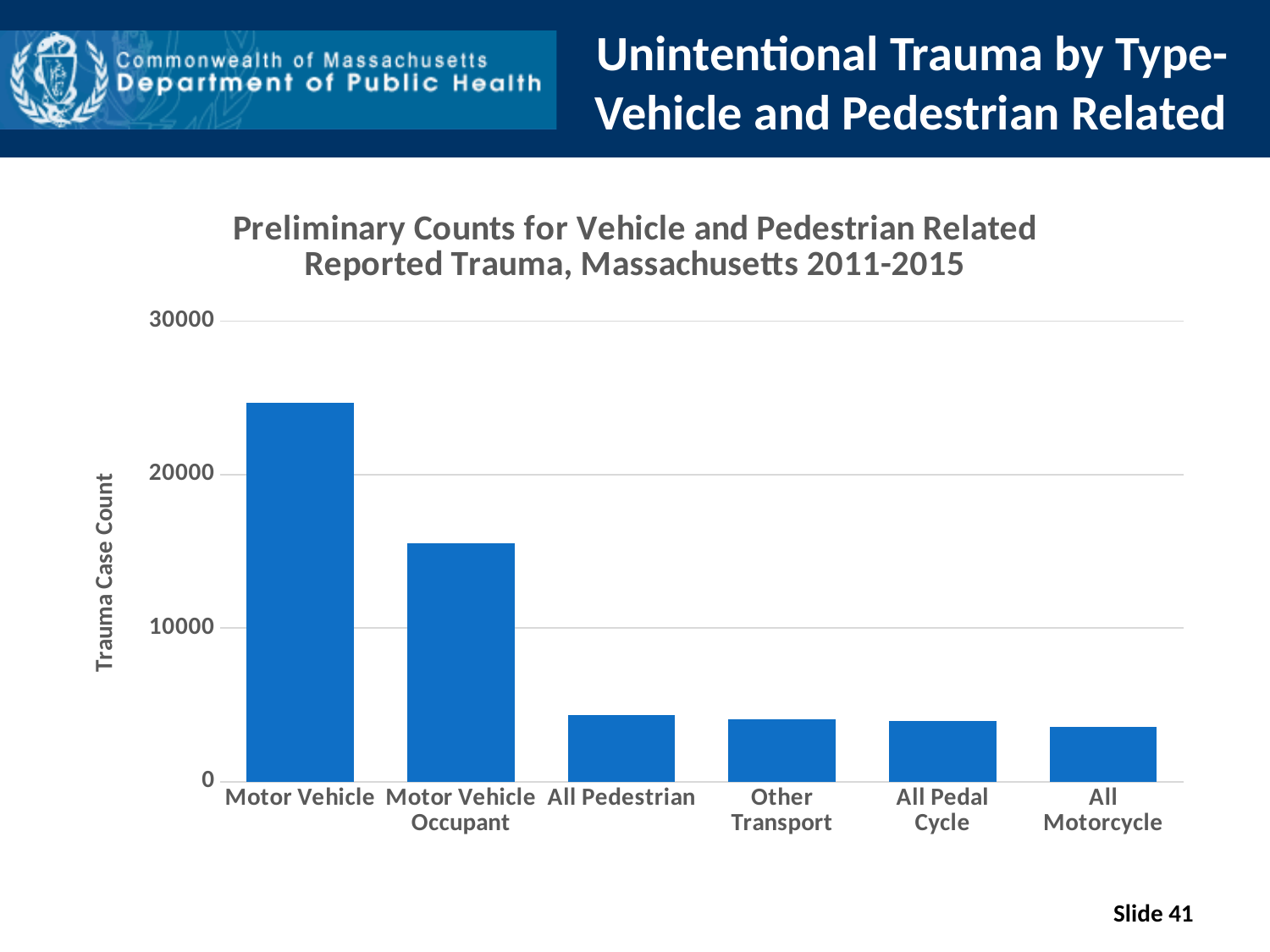
What is the label on the y axis of the chart? Trauma Case Count How many categories are shown on the x axis of the chart? 6 What kind of chart is shown on the slide? bar chart Is the value for Motor Vehicle Occupant greater or less than 10000? greater Which has a higher trauma case count, Motor Vehicle or Motor Vehicle Occupant? Motor Vehicle Which category has the lowest trauma case count? All Motorcycle Which has a higher trauma case count, Motor Vehicle Occupant or All Pedestrian? Motor Vehicle Occupant Is the value for Motor Vehicle Occupant greater or less than 20000? less Do the bar values rise or fall moving from left to right along the x axis? fall Is the value for All Pedestrian greater or less than 10000? less Which category has the highest trauma case count? Motor Vehicle